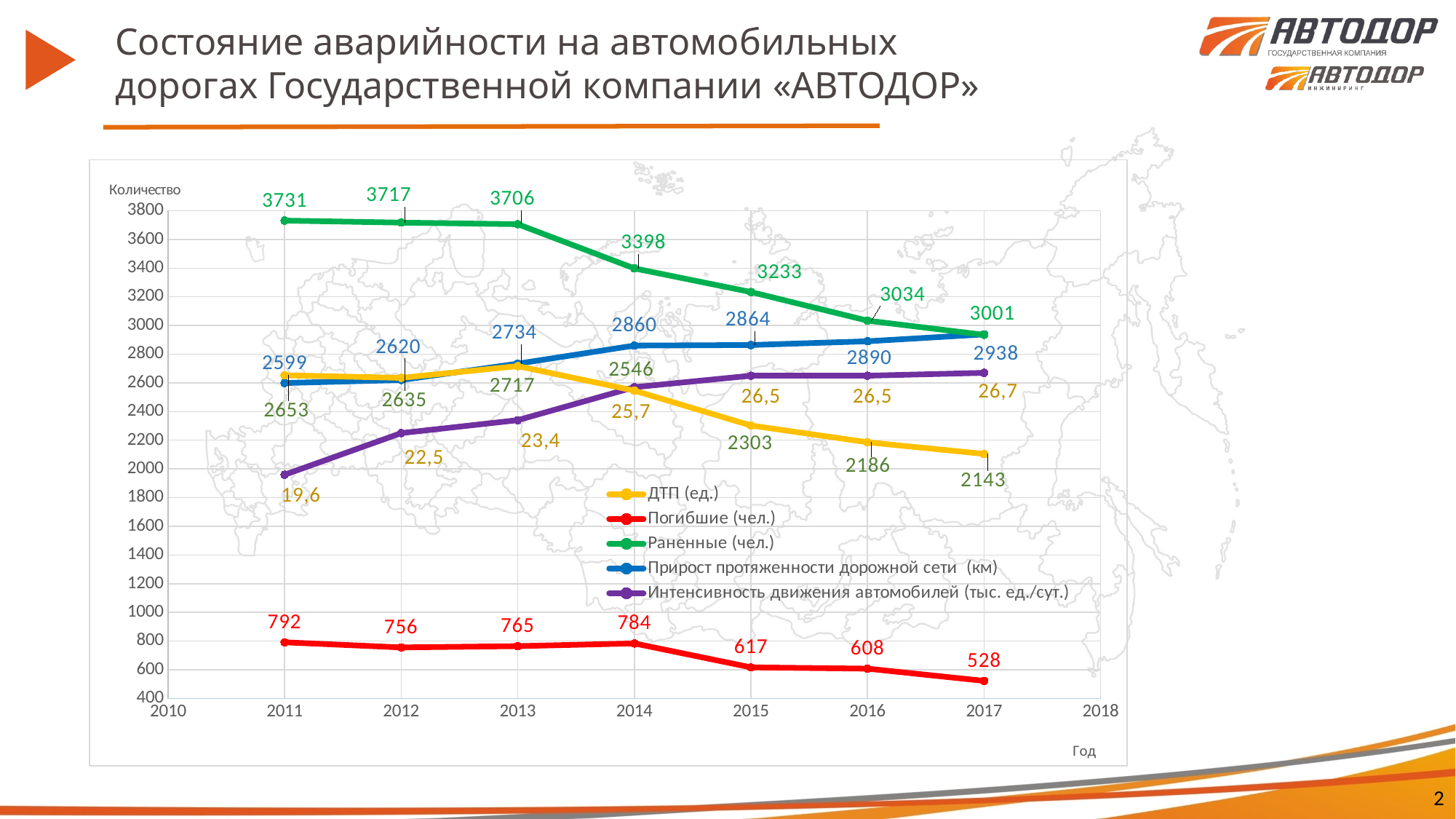
What is the value of Погибшие (чел.) in 2017? 528 Which year has the larger ДТП (ед.) value, 2011 or 2013? 2013 How many series does the legend list? 5 What is the difference between the Погибшие (чел.) values in 2014 and 2015? 167 What kind of chart is shown on the slide? line chart How many years have data points plotted on the chart? 7 What is the value of Интенсивность движения автомобилей (тыс. ед./сут.) in 2011? 19,6 What is the value of Раненные (чел.) in 2014? 3398 What is the difference between the Раненные (чел.) values in 2011 and 2017? 730 Does the Прирост протяженности дорожной сети (км) series rise or fall from 2011 to 2017? rise In which year is the Погибшие (чел.) series lowest? 2017 In which year is the Раненные (чел.) series highest? 2011